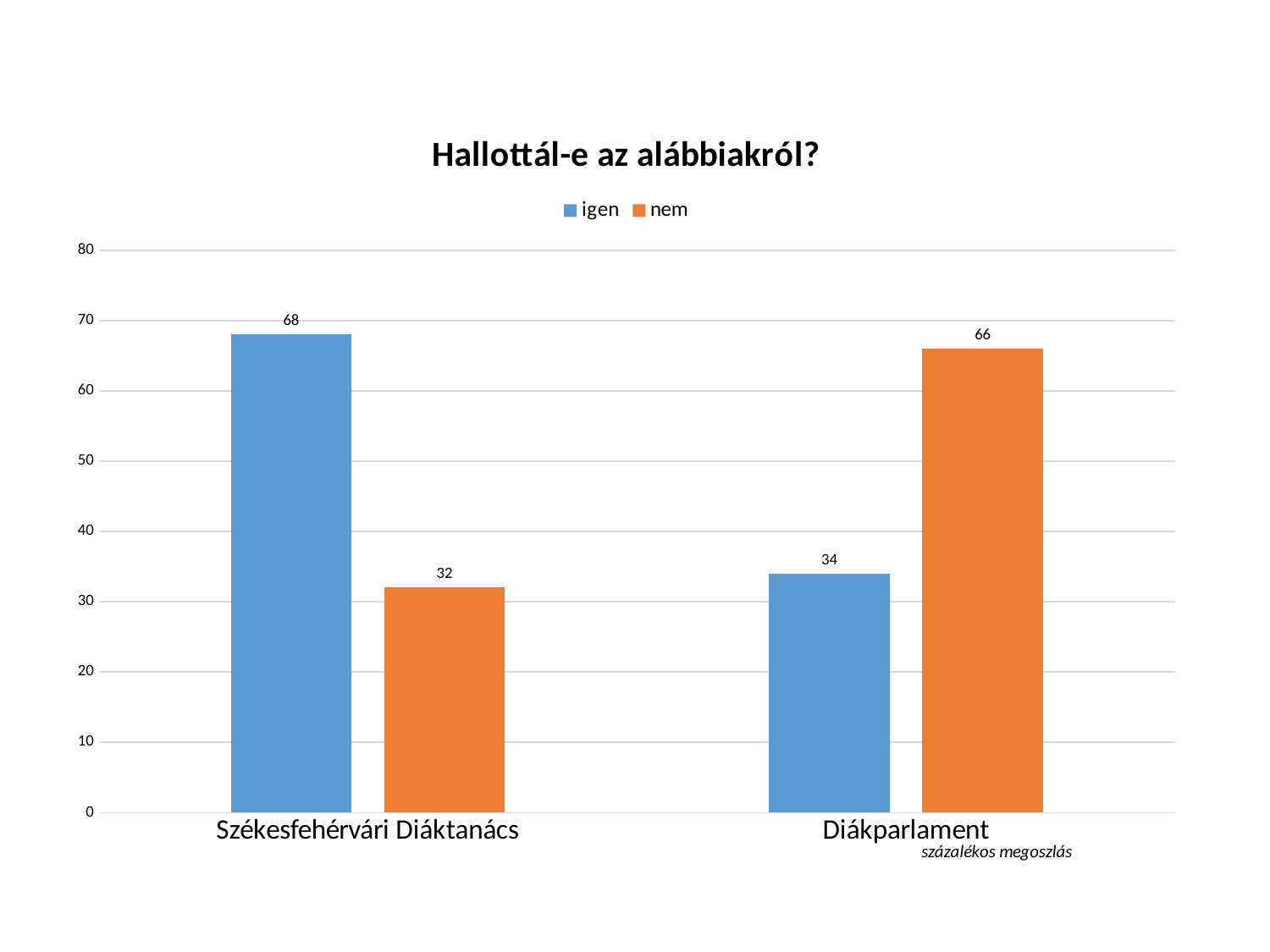
Which category has the highest "igen" value? Székesfehérvári Diáktanács What kind of chart is shown on the slide? bar chart What is the value for "igen" for Diákparlament? 34 How many categories are shown on the x axis? 2 What is the value for "nem" for Diákparlament? 66 What is the difference between the "igen" and "nem" values for Székesfehérvári Diáktanács? 36 Which is larger for Diákparlament: "igen" or "nem"? nem What is the value for "nem" for Székesfehérvári Diáktanács? 32 How many series does the legend list? 2 What is the value for "igen" for Székesfehérvári Diáktanács? 68 Which category has the lowest "nem" value? Székesfehérvári Diáktanács What is the difference between the "nem" values for Diákparlament and Székesfehérvári Diáktanács? 34